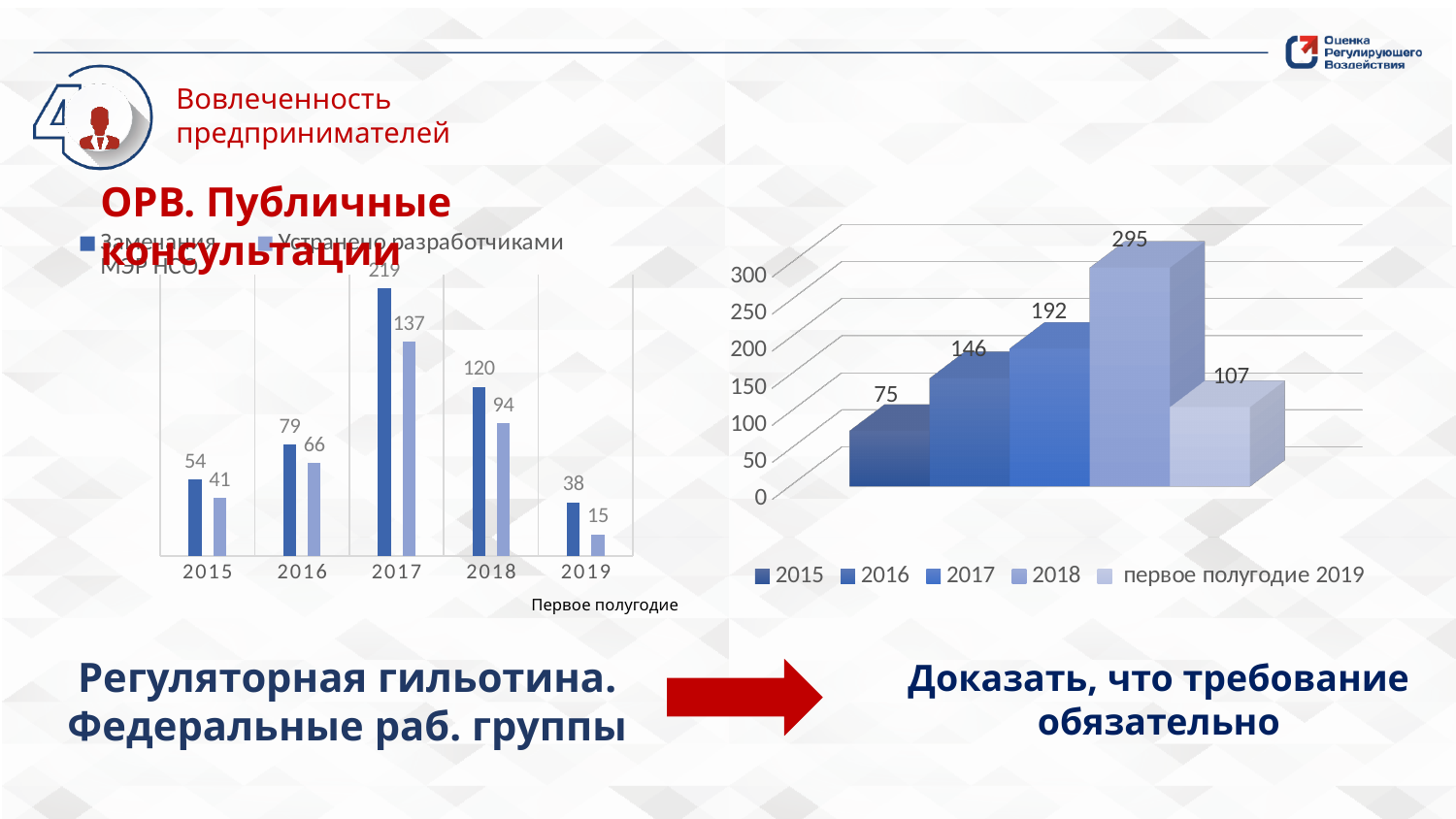
In the left chart, how many series does the legend list? 2 In the right chart, what is the value for 2018? 295 In the left chart, which year has the lowest value for Устранено разработчиками? 2019 In the left chart, what is the value for Устранено разработчиками in 2019? 15 In the right chart, what is the difference between the values for 2017 and 2016? 46 In the left chart, what is the value of the dark blue bar (Замечания МЭР НСО) for 2017? 219 In the right chart, how many bars are plotted? 5 In the left chart, what is the difference between the two series' values in 2016? 13 In the left chart, which year has the highest value for the dark blue series (Замечания МЭР НСО)? 2017 In the left chart, what is the value for Устранено разработчиками in 2018? 94 In the right chart, which category has the lowest value? 2015 In the right chart, what is the value for первое полугодие 2019? 107